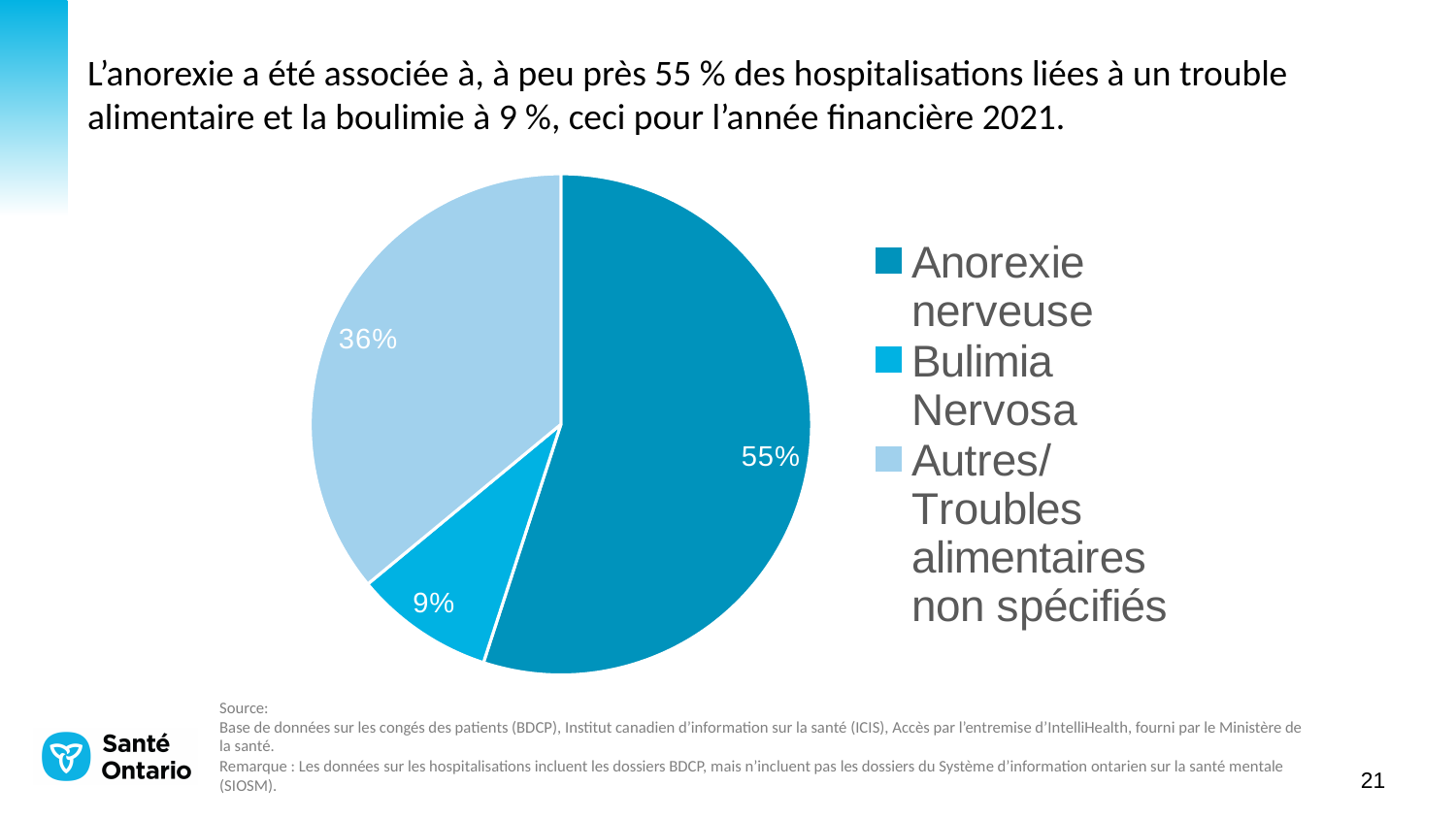
What is the difference in percentage points between the Anorexie nerveuse slice and the Autres/Troubles alimentaires non spécifiés slice? 19 How many entries does the legend list? 3 What is the difference in percentage points between the Autres/Troubles alimentaires non spécifiés slice and the Bulimia Nervosa slice? 27 What kind of chart is shown on the slide? pie chart Which is larger, the Bulimia Nervosa slice or the Autres/Troubles alimentaires non spécifiés slice? Autres/Troubles alimentaires non spécifiés Which category has the largest slice of the pie? Anorexie nerveuse What share of the pie does Autres/Troubles alimentaires non spécifiés represent? 36% How many slices does the pie chart have? 3 Which legend entry is shown in the lightest blue colour? Autres/Troubles alimentaires non spécifiés What share of the pie does Bulimia Nervosa represent? 9% What share of the pie does Anorexie nerveuse represent? 55% Which category has the smallest slice of the pie? Bulimia Nervosa